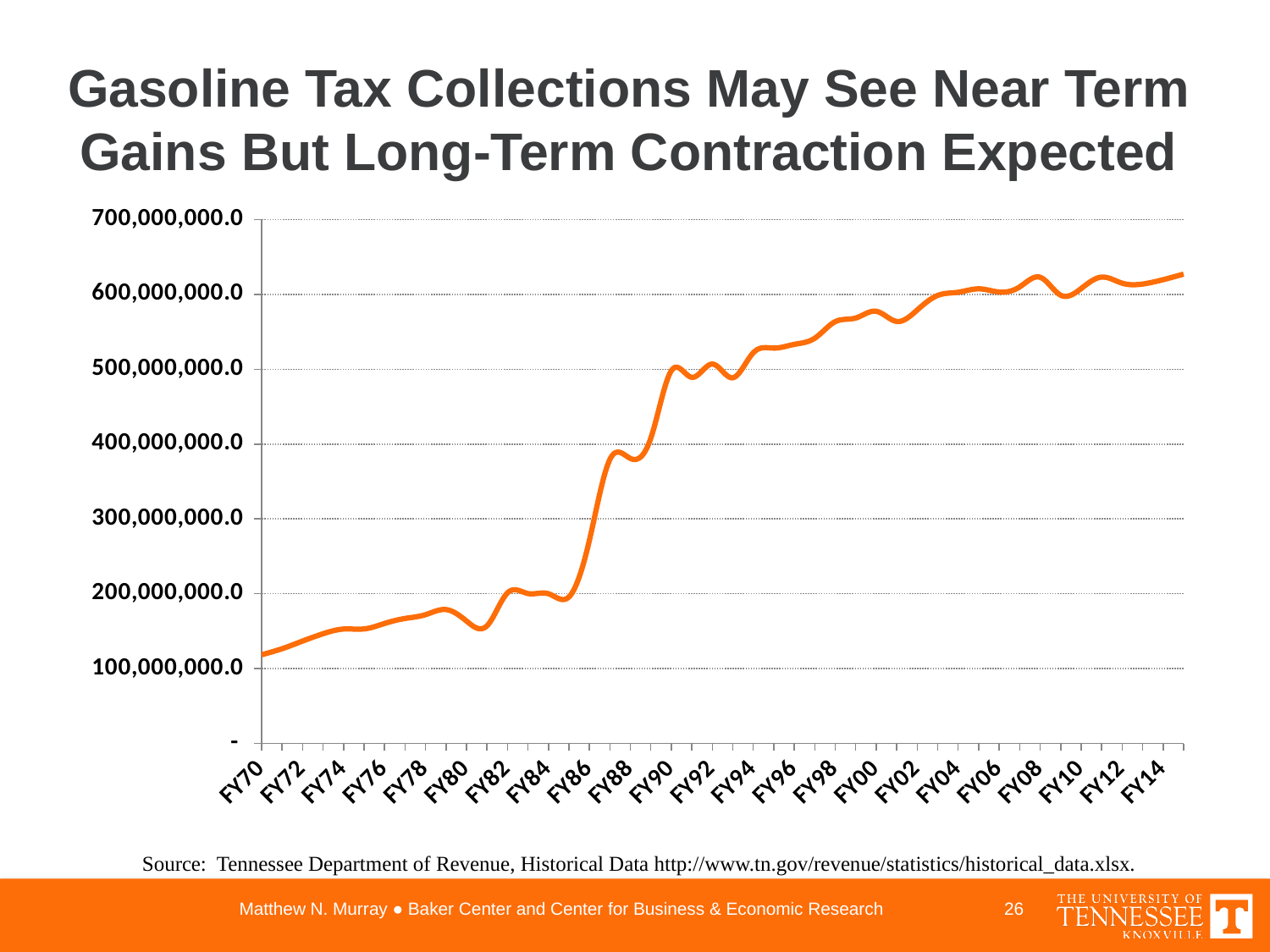
Which is larger, the value for FY80 or the value for FY88? FY88 Is the value for FY00 greater or less than 500,000,000.0? greater What kind of chart is shown on the slide? line chart Is the value for FY14 greater or less than 600,000,000.0? greater Is the value for FY88 greater or less than 300,000,000.0? greater Overall, do gasoline tax collections rise or fall from FY70 to FY14? rise Which fiscal year on the x axis has the lowest gasoline tax collections? FY70 What is the title of the chart on the slide? Gasoline Tax Collections May See Near Term Gains But Long-Term Contraction Expected What colour is the line plotted on the chart? orange How many fiscal year labels are shown on the x axis? 23